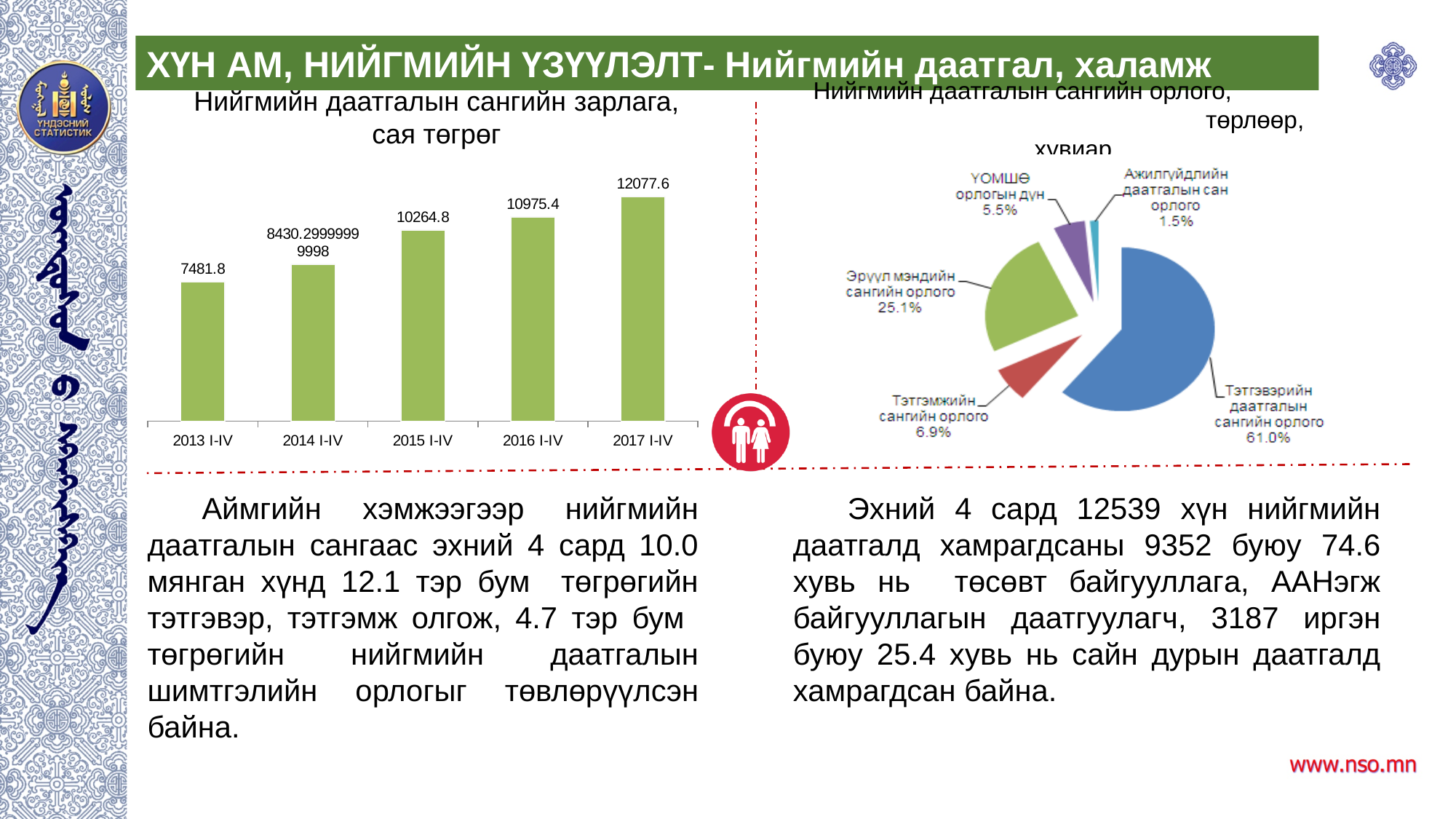
In the pie chart on the right, what share does 'Эрүүл мэндийн сангийн орлого' have? 25.1% In the pie chart on the right, what share does 'Тэтгэврийн даатгалын сангийн орлого' have? 61.0% In the bar chart 'Нийгмийн даатгалын сангийн зарлага, сая төгрөг', what is the value for 2013 I-IV? 7481.8 In the bar chart 'Нийгмийн даатгалын сангийн зарлага, сая төгрөг', which period has the highest value? 2017 I-IV In the bar chart 'Нийгмийн даатгалын сангийн зарлага, сая төгрөг', do the values rise or fall from 2013 I-IV to 2017 I-IV? rise In the bar chart 'Нийгмийн даатгалын сангийн зарлага, сая төгрөг', what is the difference between the 2017 I-IV and 2013 I-IV values? 4595.8 In the bar chart 'Нийгмийн даатгалын сангийн зарлага, сая төгрөг', what is the value for 2017 I-IV? 12077.6 In the bar chart 'Нийгмийн даатгалын сангийн зарлага, сая төгрөг', which period has the lowest value? 2013 I-IV What type of chart is the left chart titled 'Нийгмийн даатгалын сангийн зарлага, сая төгрөг'? bar chart In the bar chart 'Нийгмийн даатгалын сангийн зарлага, сая төгрөг', how many periods are shown on the x axis? 5 In the bar chart 'Нийгмийн даатгалын сангийн зарлага, сая төгрөг', what is the value for 2015 I-IV? 10264.8 In the pie chart on the right, which slice is the smallest? Ажилгүйдлийн даатгалын сан орлого